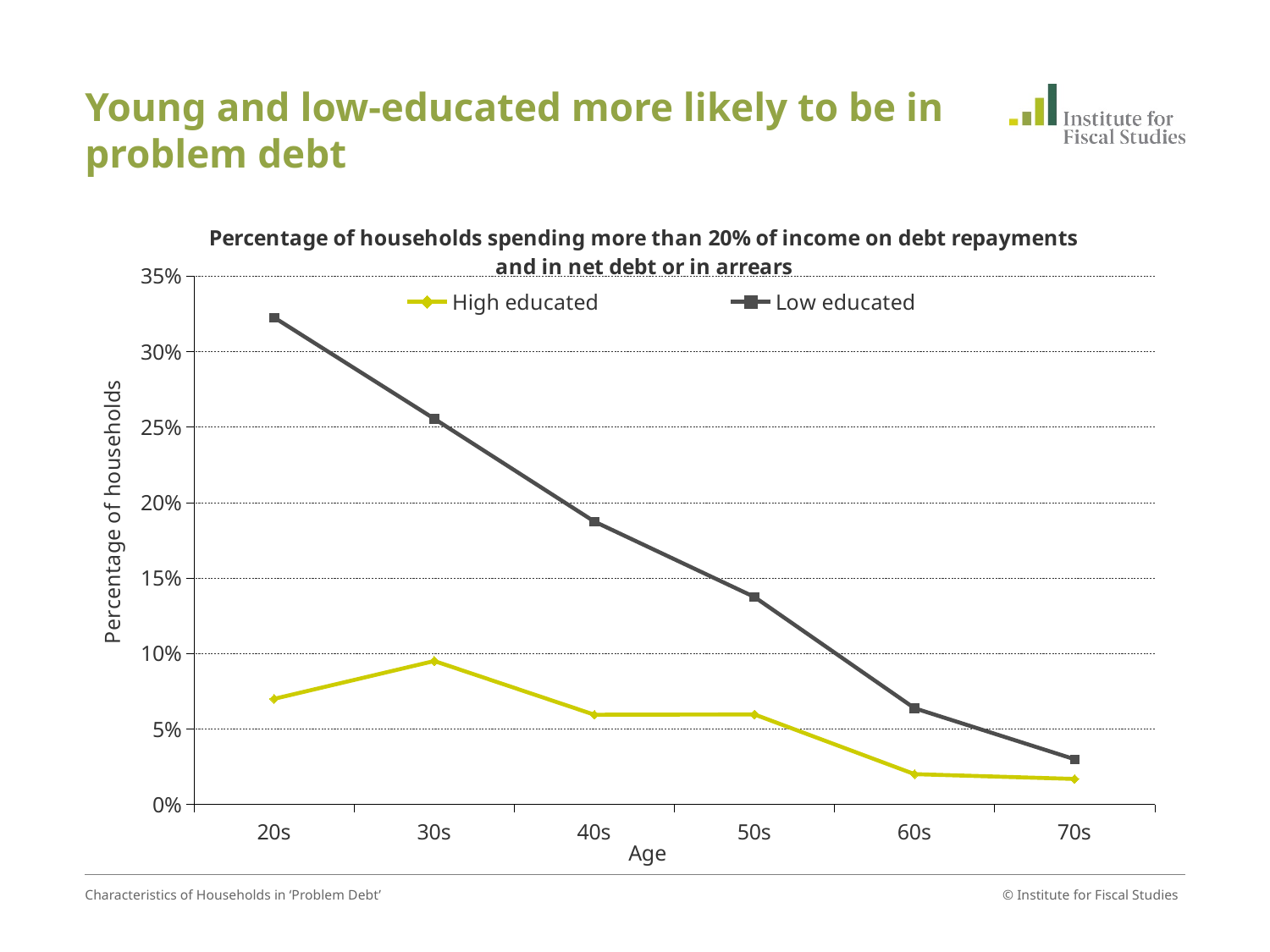
How many series does the legend list? 2 Which age group has the highest value for the Low educated series? 20s Which age group has the highest value for the High educated series? 30s How many age groups are plotted along the x axis? 6 For households in their 40s, which series has the larger value, High educated or Low educated? Low educated Which age group has the lowest value for the Low educated series? 70s Does the Low educated series rise or fall as age increases from 20s to 70s? Fall What is the label on the y axis of the chart? Percentage of households Is the value for Low educated households in their 50s greater or less than 15%? less What kind of chart is shown on the slide? Line chart Is the value for Low educated households in their 20s greater or less than 30%? greater Is the value for High educated households in their 60s greater or less than 5%? less